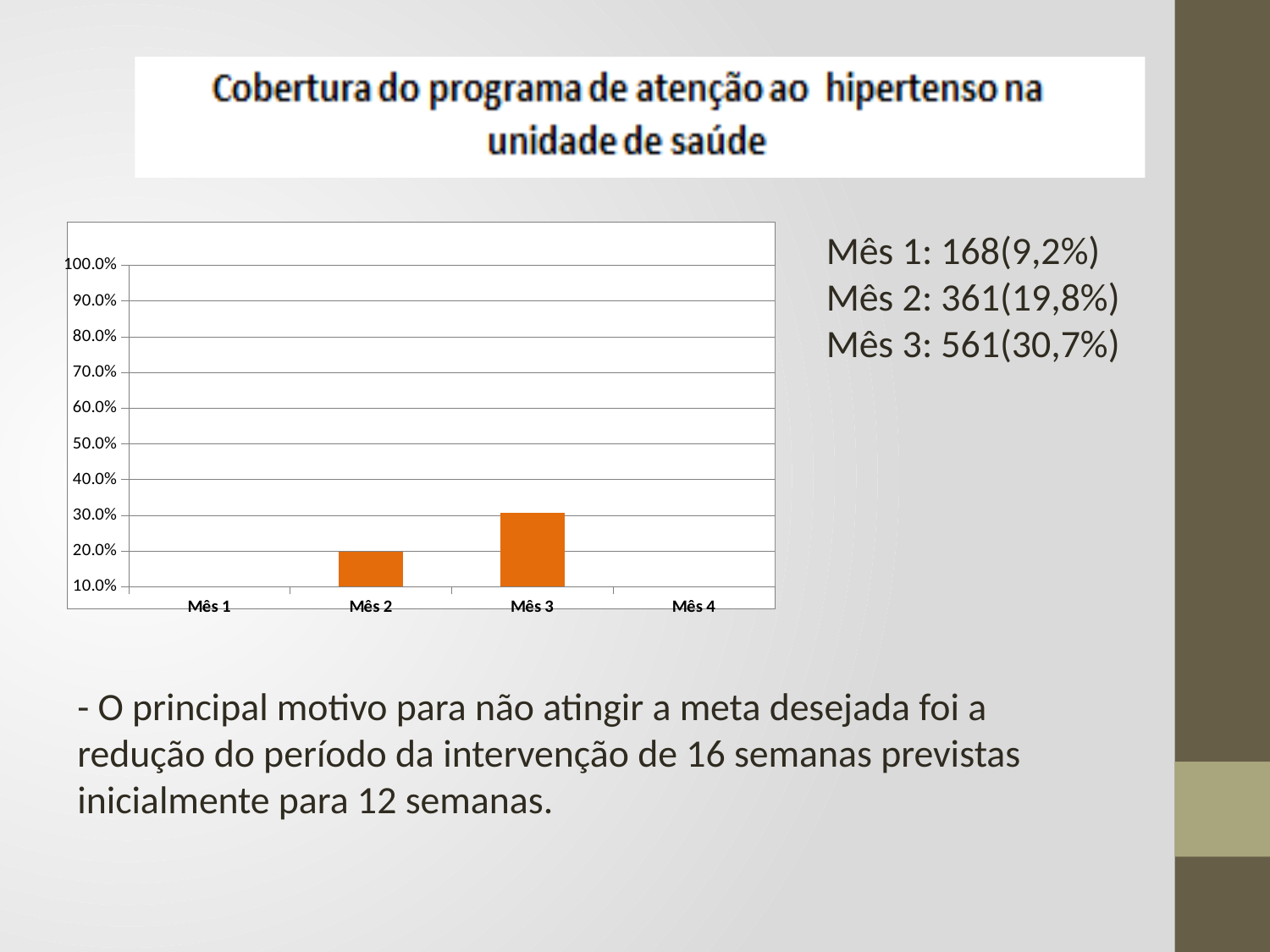
What is the title of the chart? Cobertura do programa de atenção ao hipertenso na unidade de saúde Is the value for Mês 3 greater or less than 20%? greater What kind of chart is shown on the slide? bar chart Do the bar values rise or fall from Mês 2 to Mês 3? rise What is the lowest tick value shown on the y axis of the chart? 10.0% Which bar is taller, Mês 2 or Mês 3? Mês 3 How many categories are shown on the x axis of the chart? 4 Is the value for Mês 3 greater or less than 50%? less Is the value for Mês 2 greater or less than 40%? less What is the highest value shown on the y axis of the chart? 100.0% Which category has the tallest bar in the chart? Mês 3